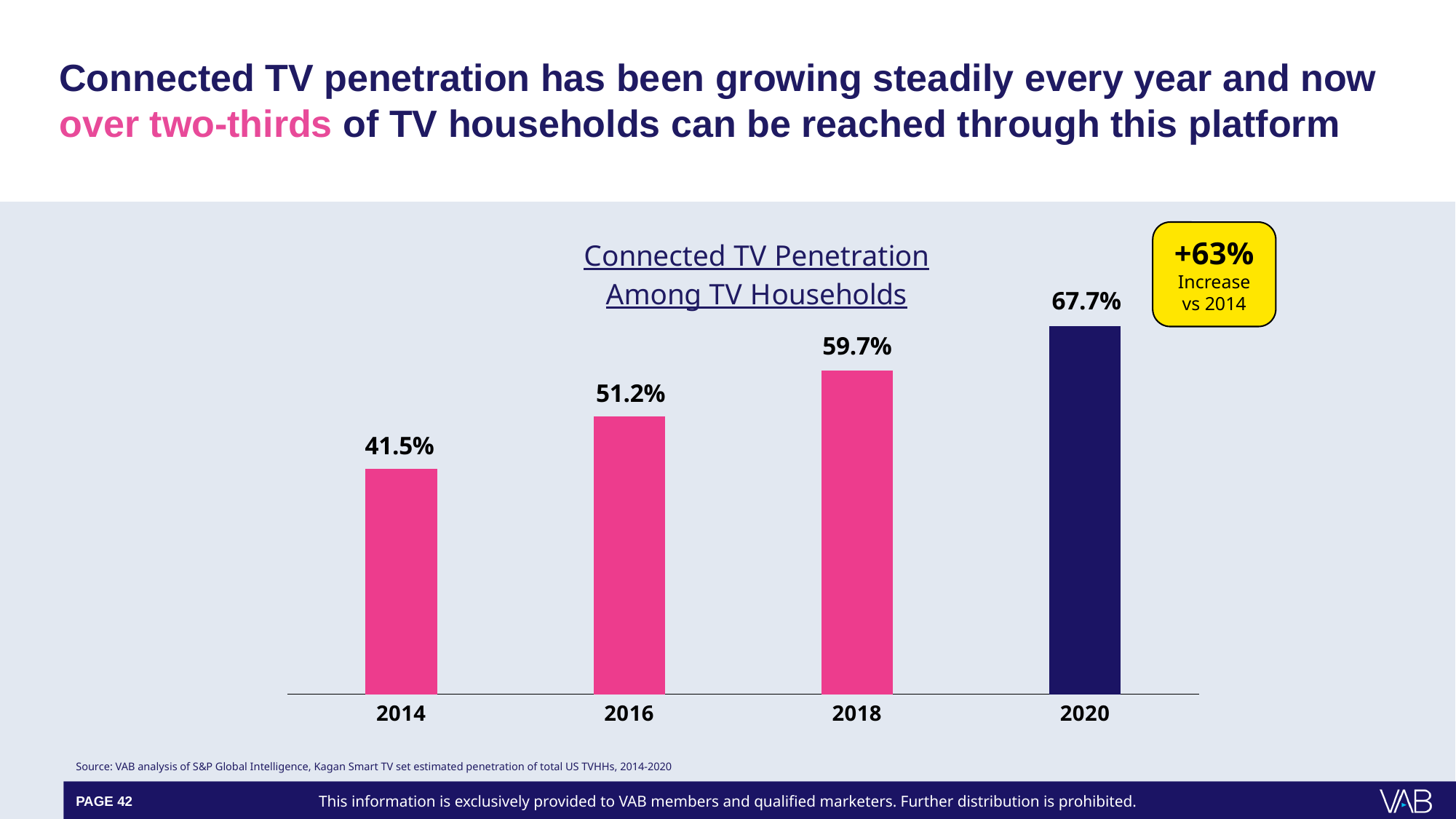
What is the difference in Connected TV penetration between 2018 and 2016? 8.5 percentage points What is the Connected TV penetration among TV households in 2016? 51.2% What is the Connected TV penetration among TV households in 2018? 59.7% Which year has a higher Connected TV penetration, 2016 or 2018? 2018 What is the difference in Connected TV penetration between 2020 and 2014? 26.2 percentage points Which year has the lowest Connected TV penetration? 2014 Does Connected TV penetration rise or fall from 2014 to 2020? Rise What is the Connected TV penetration among TV households in 2014? 41.5% What kind of chart is used to show Connected TV penetration? Bar chart How many years are shown on the chart? 4 Which year has the highest Connected TV penetration? 2020 What is the Connected TV penetration among TV households in 2020? 67.7%